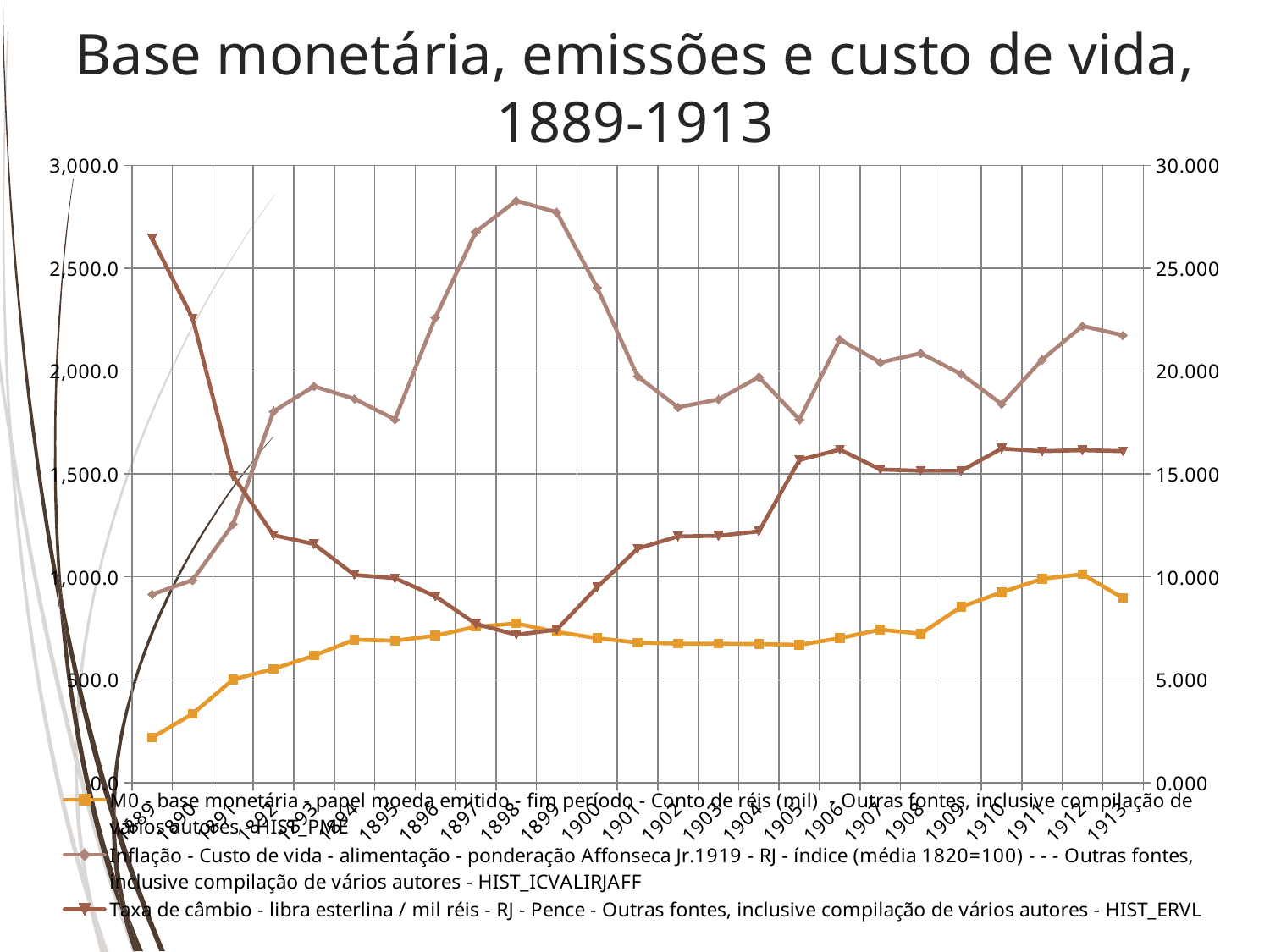
In which year is the M0 base monetária series at its lowest point? 1889 What is the first year shown on the x axis? 1889 What kind of chart is shown on the slide? line chart How many series does the legend list? 3 How many years are plotted along the x axis? 25 In which year is the Taxa de câmbio series at its highest point? 1889 In which year is the Inflação (custo de vida) series at its lowest point? 1889 Does the M0 base monetária series generally rise or fall from 1889 to 1912? rise Which is larger for the Taxa de câmbio series: the value in 1889 or the value in 1913? 1889 In which year does the Inflação (custo de vida) series reach its highest point? 1898 What is the highest value shown on the right-hand axis? 30.000 Does the Taxa de câmbio series rise or fall between 1889 and 1898? fall